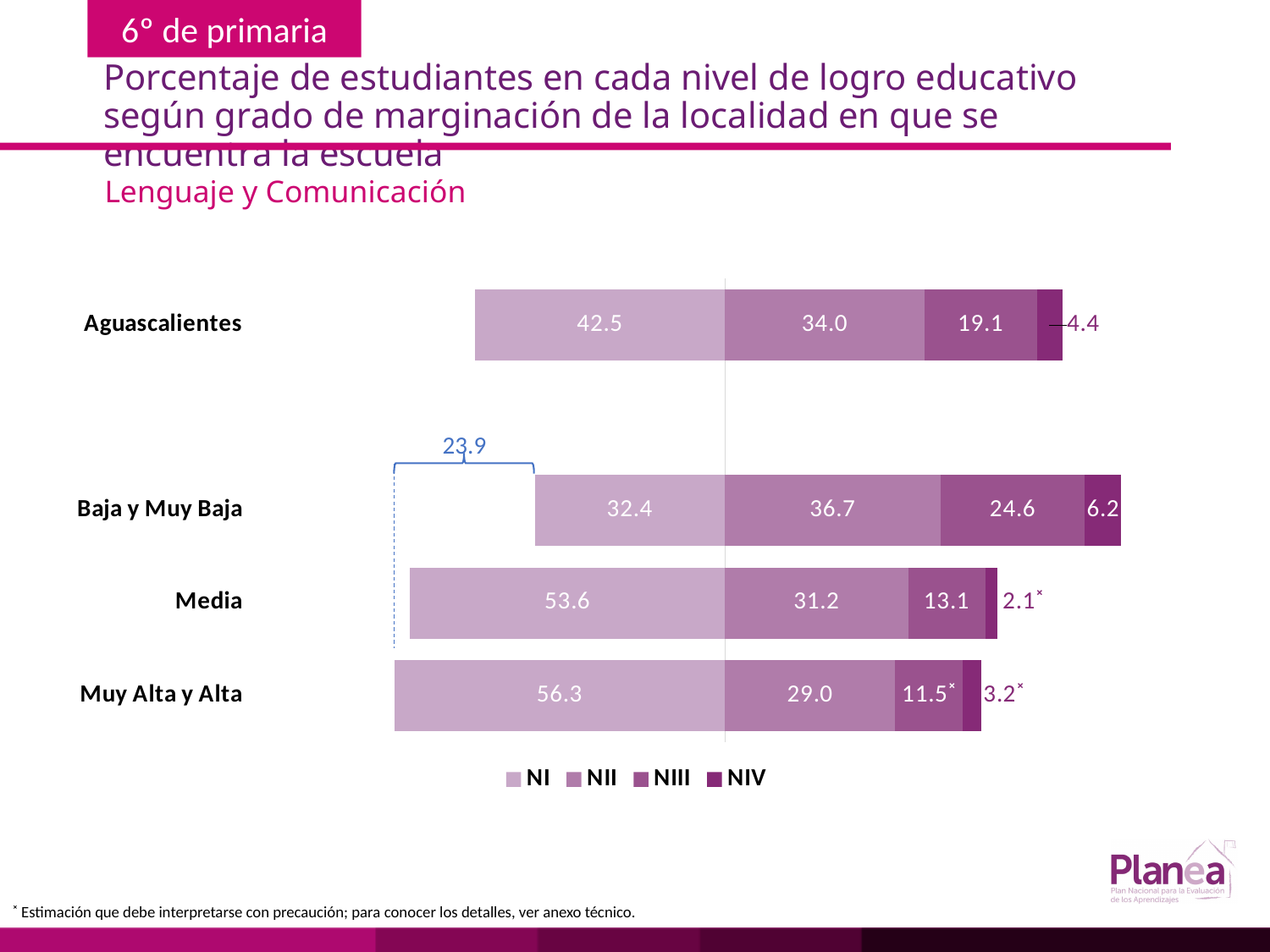
What is the NIII value for Muy Alta y Alta? 11.5 How many series does the legend list? 4 Which is larger, the NIII value for Aguascalientes or the NIII value for Media? Aguascalientes Which category has the highest NI value? Muy Alta y Alta What is the NII value for Baja y Muy Baja? 36.7 How many categories are plotted on the chart? 4 What is the total of the stacked bar for Aguascalientes? 100.0 What is the difference between the NI values for Muy Alta y Alta and Baja y Muy Baja? 23.9 What is the NIV value for Aguascalientes? 4.4 What kind of chart is shown on the slide? Stacked bar chart Which category has the lowest NIV value? Media What is the NI value for Media? 53.6